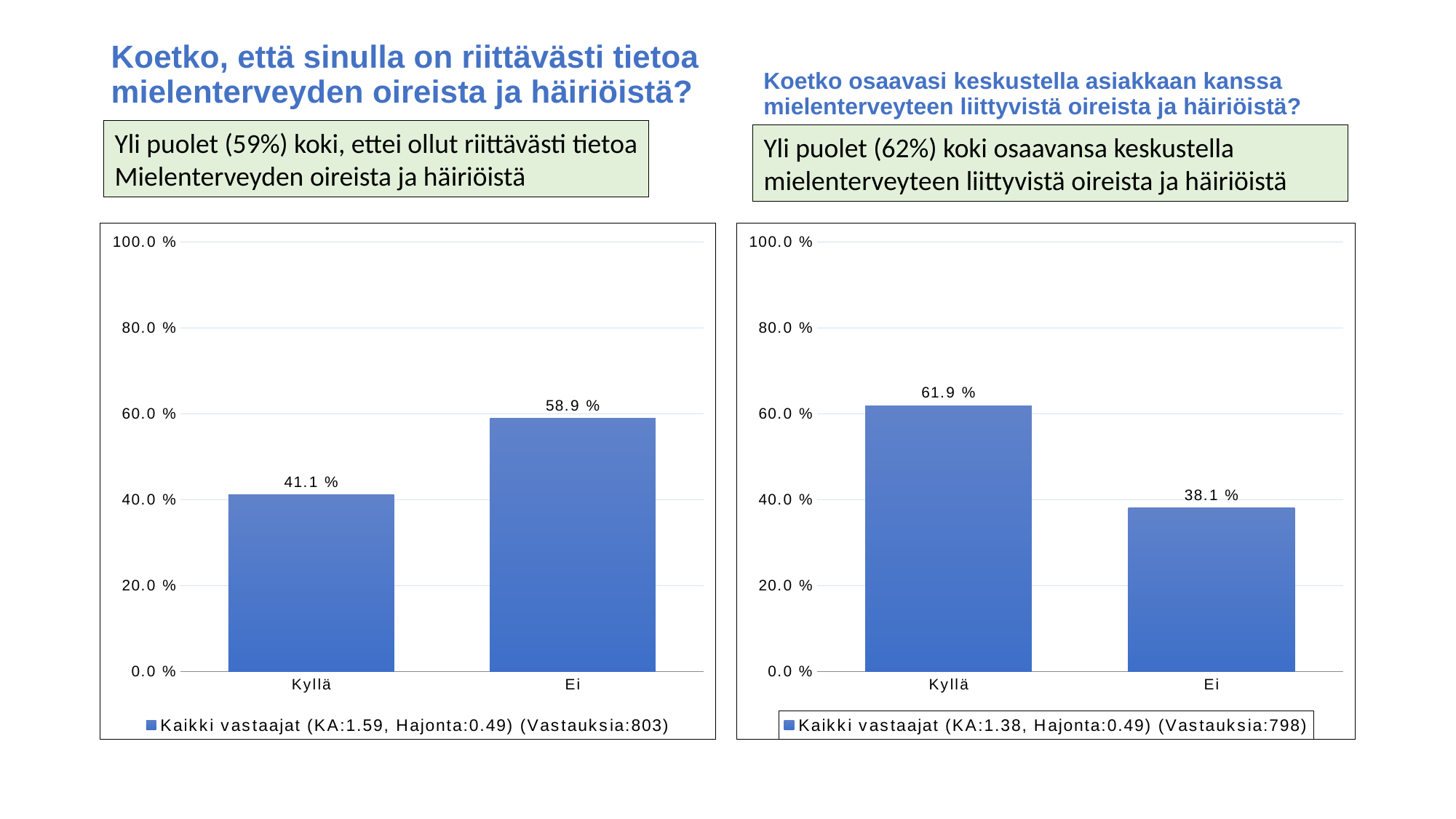
What kind of chart is the right chart? bar chart In the right chart, what is the value for Kyllä? 61.9 % In the right chart, what is the value for Ei? 38.1 % In the left chart, what is the value for Kyllä? 41.1 % In the right chart, which is larger, the value for Kyllä or the value for Ei? Kyllä How many series does the legend of the left chart list? 1 In the left chart, what is the value for Ei? 58.9 % In the right chart, which category has the lowest value? Ei How many categories are shown in the left chart? 2 In the left chart, what is the difference between the values for Ei and Kyllä? 17.8 % In the left chart, which category has the highest value? Ei In the right chart, what is the difference between the values for Kyllä and Ei? 23.8 %